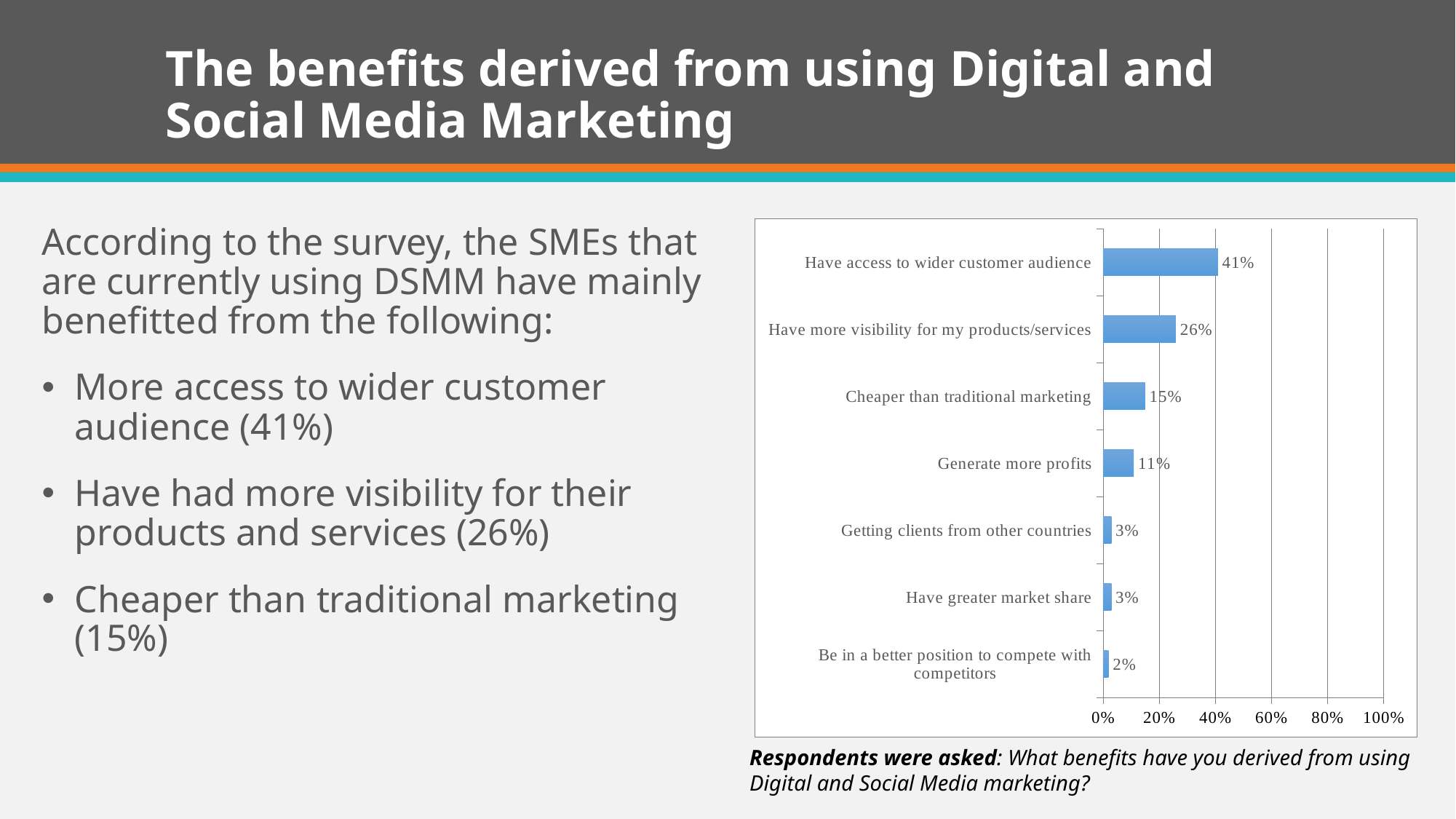
What value is shown for 'Be in a better position to compete with competitors'? 2% Is the value for 'Have more visibility for my products/services' greater or less than 20%? greater What value is shown for 'Cheaper than traditional marketing'? 15% What percentage is shown for 'Generate more profits'? 11% What percentage of respondents said they have access to a wider customer audience? 41% Which benefit has the lowest percentage? Be in a better position to compete with competitors Which is larger: 'Cheaper than traditional marketing' or 'Generate more profits'? Cheaper than traditional marketing What type of chart is shown on the slide? Bar chart Which benefit has the highest percentage? Have access to wider customer audience How many benefit categories are shown in the chart? 7 What is the maximum value shown on the chart's horizontal axis? 100% What is the difference between 'Have access to wider customer audience' and 'Have more visibility for my products/services'? 15 percentage points